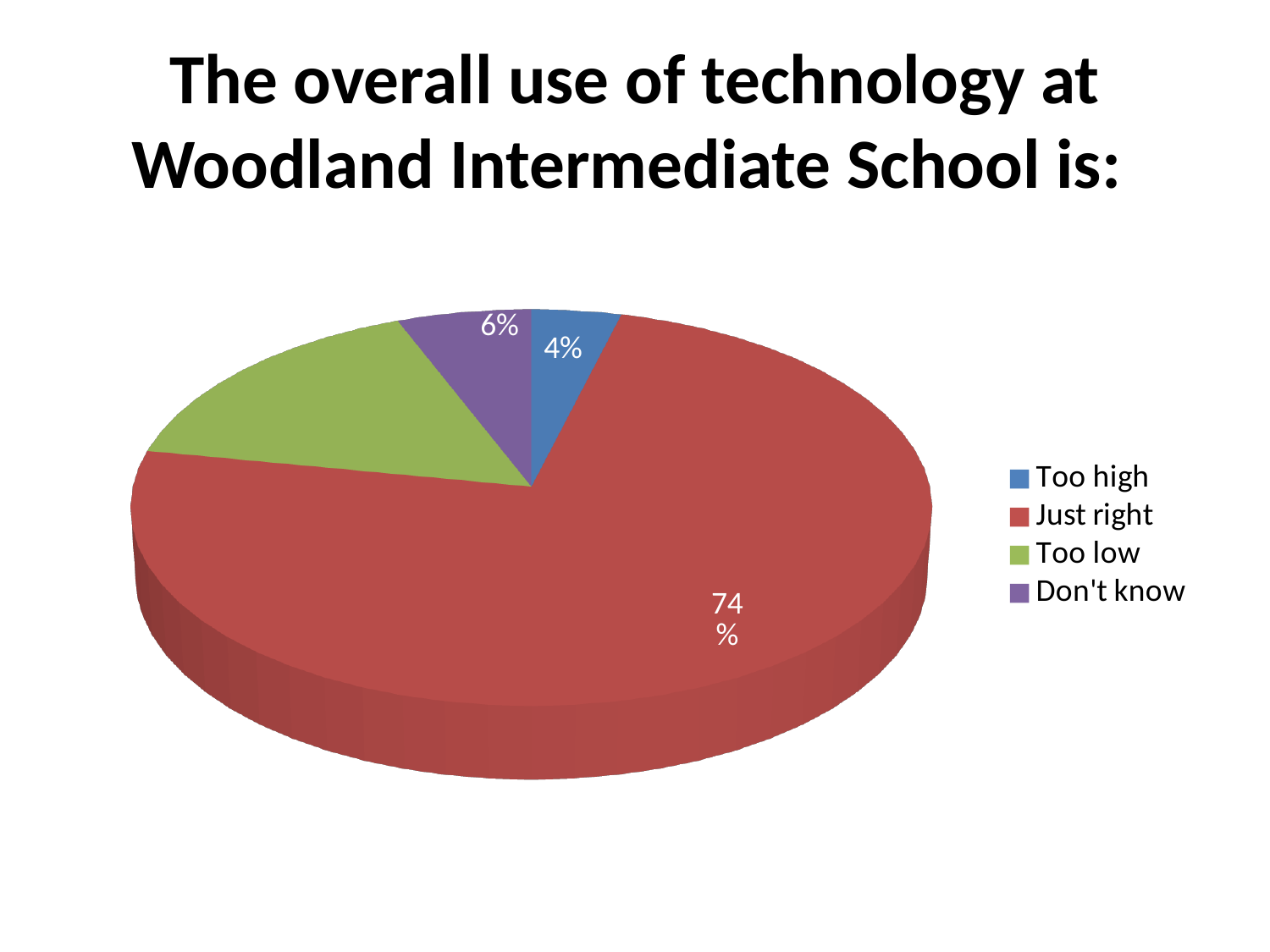
What colour represents the "Just right" category in the chart? Red What percentage of respondents said the overall use of technology is "Just right"? 74% What percentage of respondents answered "Don't know"? 6% Which response category has the smallest share of the pie? Too high What percentage of respondents said the overall use of technology is "Too high"? 4% How many entries does the legend list? 4 Which response category has the largest share of the pie? Just right Which is larger, the share for "Too high" or the share for "Don't know"? Don't know What is the difference between the "Don't know" share and the "Too high" share? 2% What kind of chart is shown on the slide? Pie chart How many response categories are shown in the pie chart? 4 What is the difference between the "Just right" share and the "Too high" share? 70%